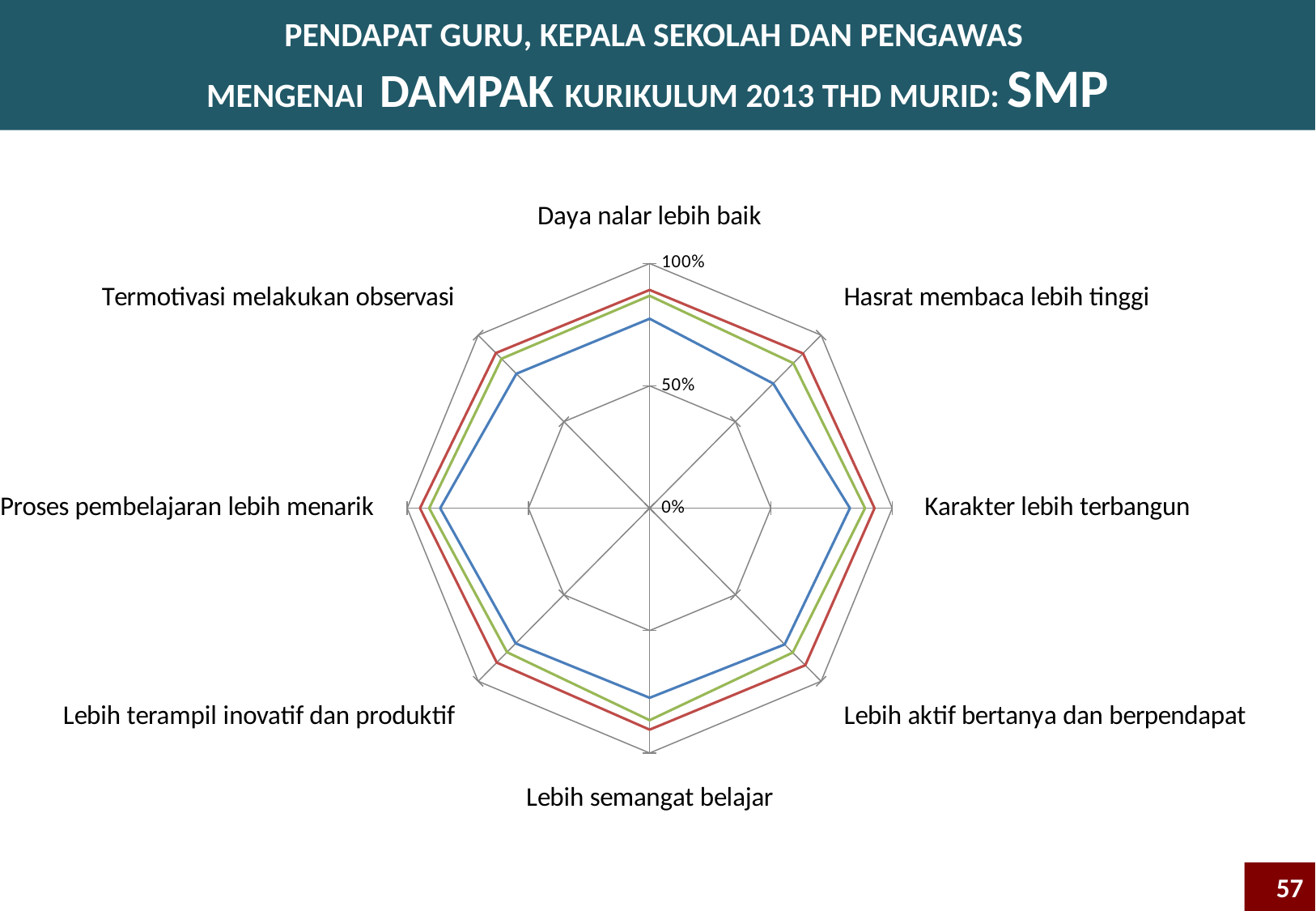
For "Proses pembelajaran lebih menarik", which line has the larger value, the red line or the blue line? Red line Which category label appears at the top of the radar chart? Daya nalar lebih baik How many coloured data lines are plotted on the radar chart? 3 Which coloured line lies innermost (has the lowest values) across all categories? Blue line Is the red line's value for "Karakter lebih terbangun" greater or less than 50%? greater Is the blue line's value for "Daya nalar lebih baik" greater or less than 50%? greater What percentage labels are shown on the radar chart's axis? 0%, 50%, 100% Is the green line's value for "Termotivasi melakukan observasi" greater or less than 50%? greater For "Lebih semangat belajar", which line has the larger value, the green line or the blue line? Green line What kind of chart is shown on the slide? Radar chart How many categories (axes) does the radar chart have? 8